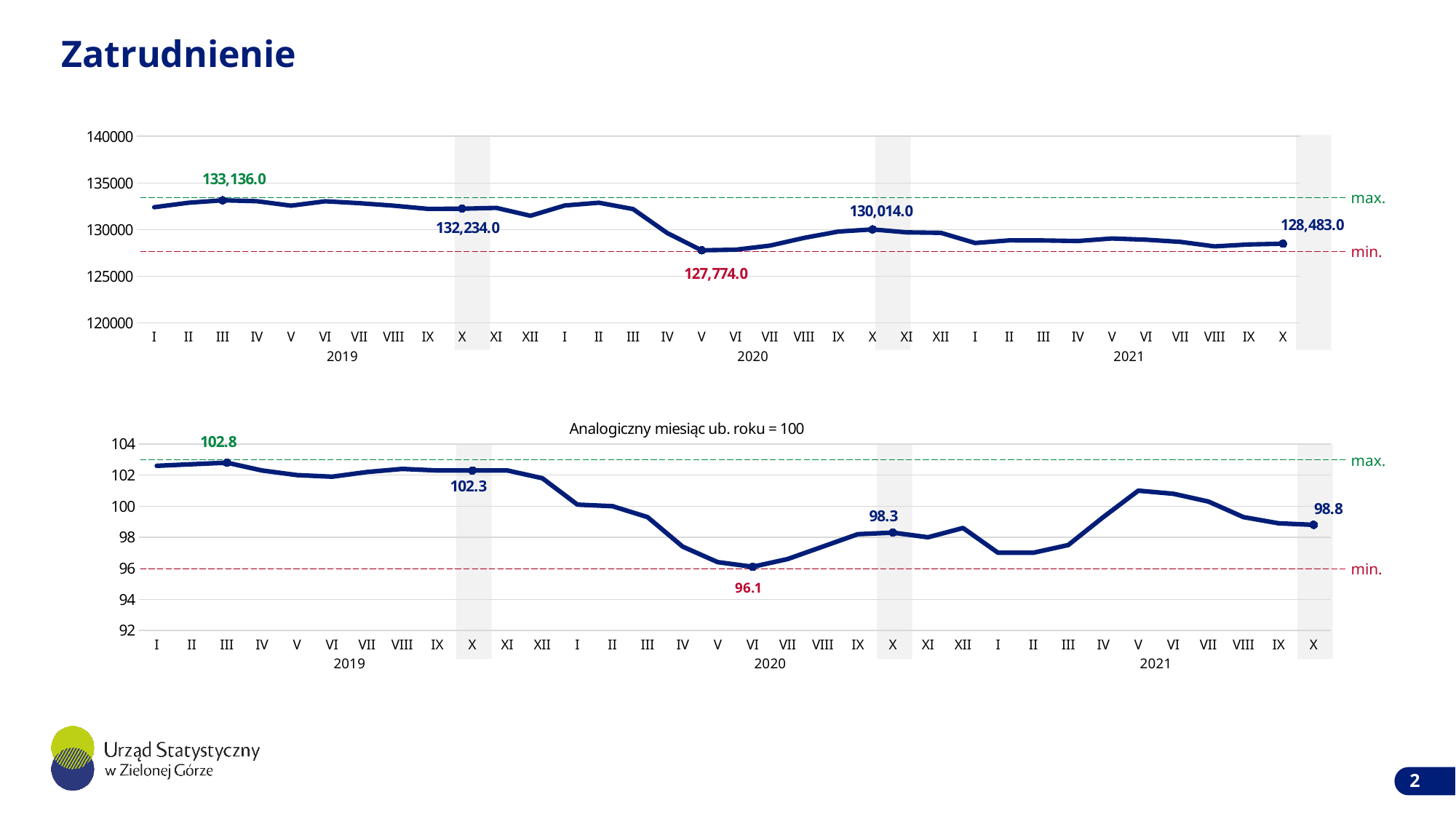
In the bottom chart (Analogiczny miesiąc ub. roku = 100), what is the difference between the October 2021 value and the October 2020 value? 0.5 In the top chart, what is the value labelled for October (X) 2021? 128,483.0 In the top chart, which month has the lowest value? V 2020 In the bottom chart (Analogiczny miesiąc ub. roku = 100), which month has the highest value? III 2019 In the top chart, what is the difference between the October 2019 value and the October 2020 value? 2,220.0 In the bottom chart (Analogiczny miesiąc ub. roku = 100), what is the value labelled for June (VI) 2020? 96.1 What kind of chart is the top chart? line chart What is the title shown above the bottom chart? Analogiczny miesiąc ub. roku = 100 In the bottom chart (Analogiczny miesiąc ub. roku = 100), is the value for May (V) 2021 greater or less than 100? greater In the top chart, what is the value labelled for March (III) 2019? 133,136.0